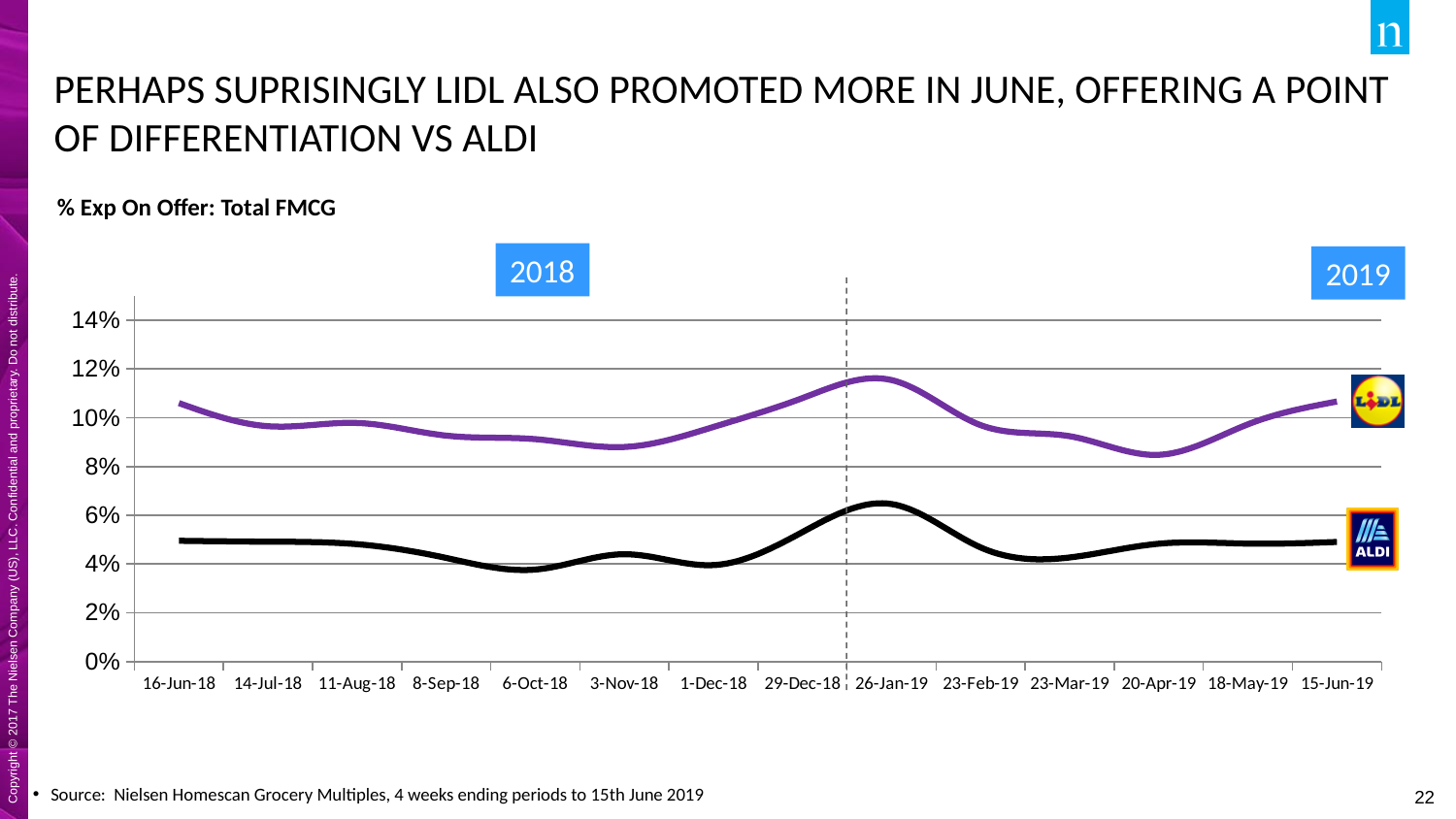
What kind of chart is shown on the slide? line chart Is the value for Aldi at 6-Oct-18 greater or less than 4%? less How many lines (series) are plotted on the chart? 2 At which date does the Aldi line reach its highest value? 26-Jan-19 Is the value for Lidl at 26-Jan-19 greater or less than 10%? greater Is the value for Aldi at 26-Jan-19 greater or less than 6%? greater Does the Lidl line rise or fall between 20-Apr-19 and 15-Jun-19? rise How many dates are shown along the x axis of the chart? 14 What is the subtitle printed above the chart? % Exp On Offer: Total FMCG At which date does the Lidl line reach its highest value? 26-Jan-19 Which retailer's line is higher across the whole chart, Lidl or Aldi? Lidl